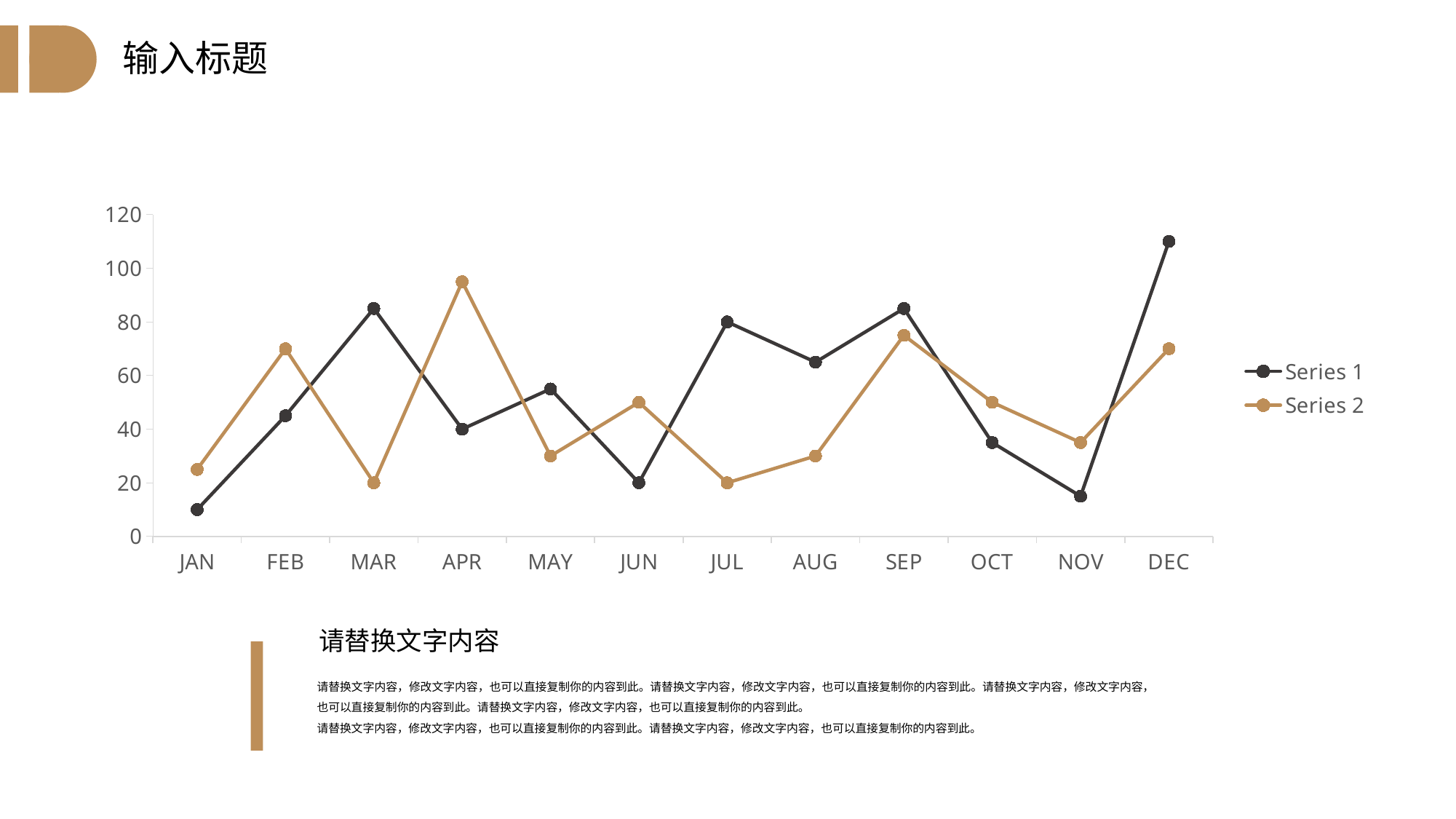
In which month does Series 2 reach its highest value? APR What is the value of Series 1 in JUL? 80 Does Series 1 rise or fall from SEP to NOV? fall Is the value for Series 1 in DEC greater or less than 100? greater Is the value for Series 1 in JAN greater or less than 20? less How many series does the legend list? 2 What kind of chart is shown on the slide? line chart What is the value of Series 1 in APR? 40 In which month does Series 1 reach its highest value? DEC How many months are shown on the x axis? 12 Is the value for Series 2 in APR greater or less than 80? greater In JAN, which series has the larger value, Series 1 or Series 2? Series 2